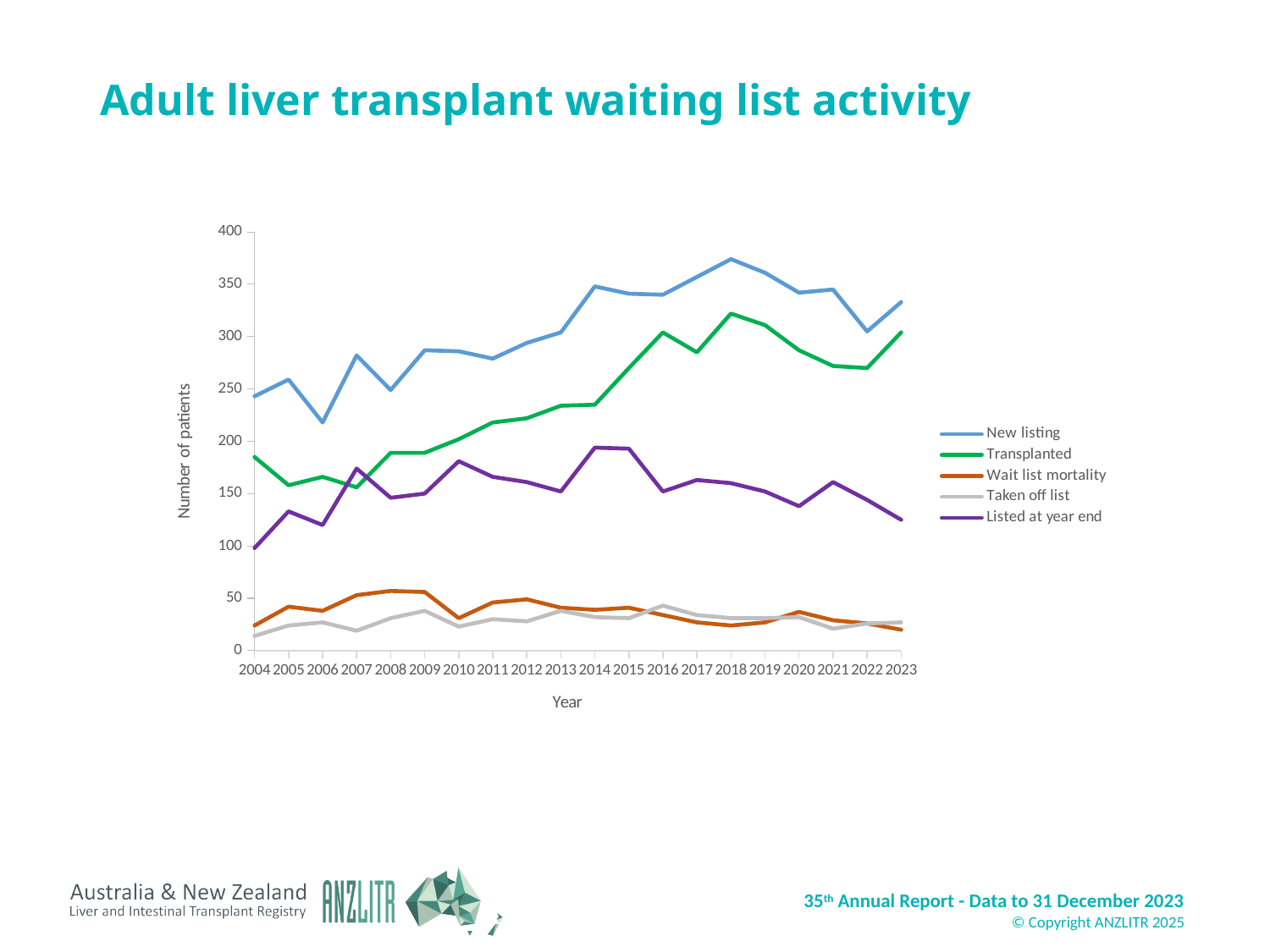
In 2023, which is larger: New listing or Transplanted? New listing In 2004, which is larger: Wait list mortality or Taken off list? Wait list mortality Is the Listed at year end value for 2023 greater or less than 150? less Is the Transplanted value for 2018 greater or less than 300? greater In which year does the New listing series reach its lowest value? 2006 Is the New listing value for 2018 greater or less than 350? greater What type of chart is shown on the slide? Line chart How many years are plotted along the x axis? 20 In which year does the New listing series reach its highest value? 2018 What is the label on the y axis? Number of patients How many series does the legend list? 5